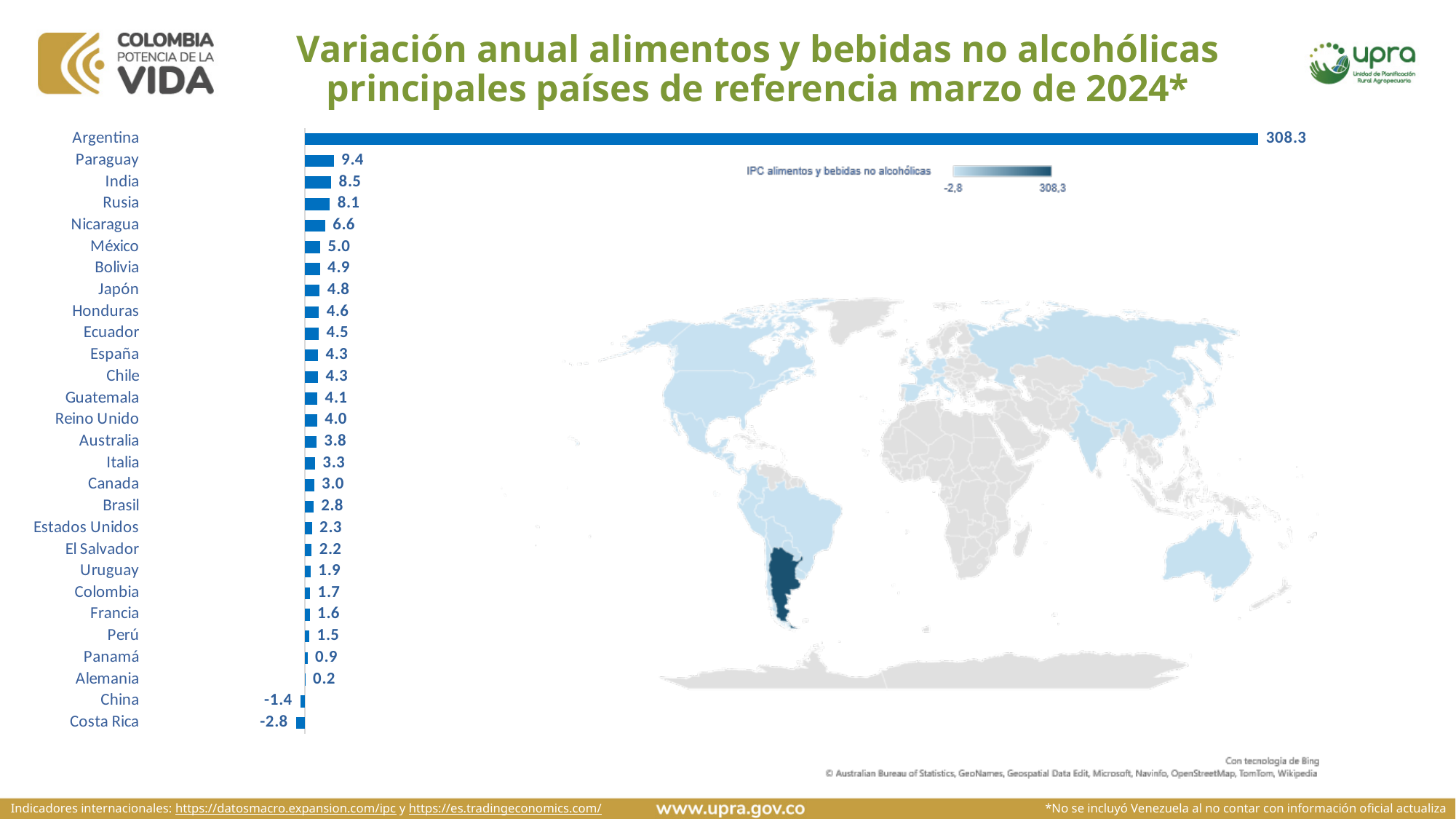
In the bar chart, what is the value for Argentina? 308.3 In the bar chart, which has a larger value, México or Brasil? México What is the title of the slide's chart? Variación anual alimentos y bebidas no alcohólicas principales países de referencia marzo de 2024* In the bar chart, which country has the highest value? Argentina How many countries are shown in the bar chart? 28 What kind of chart is used to show the values by country on the left of the slide? Bar chart In the bar chart, which country has the lowest value? Costa Rica In the bar chart, what is the value for China? -1.4 In the bar chart, what is the difference between the values for Rusia and Nicaragua? 1.5 In the bar chart, what is the difference between the values for Paraguay and India? 0.9 In the bar chart, what is the value for Colombia? 1.7 In the bar chart, what is the value for Costa Rica? -2.8